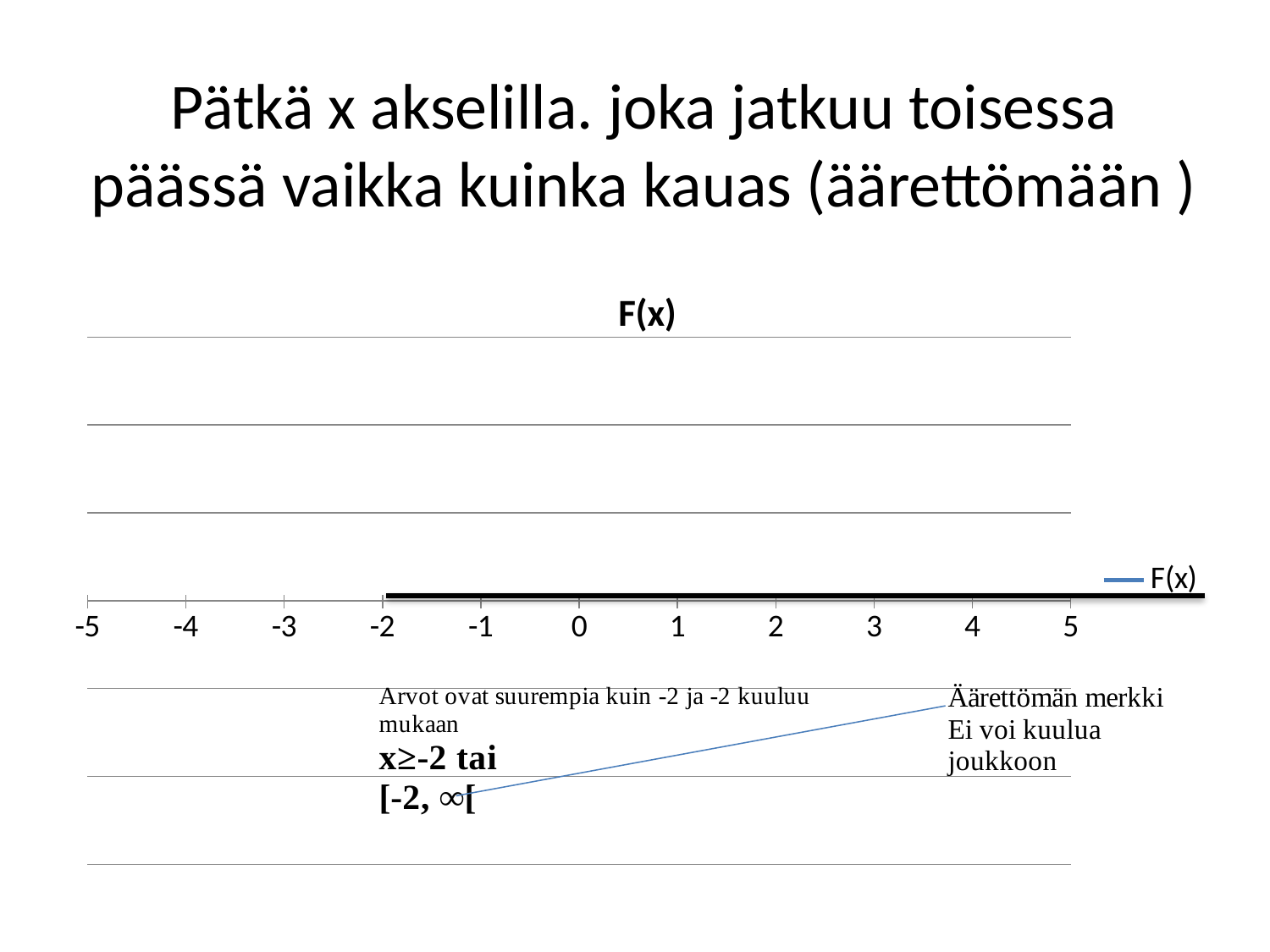
Does the plotted line extend to the left of x = -2? No How many series does the chart legend list? 1 Which interval notation is written below the chart for the plotted set? [-2, ∞[ What kind of chart is shown on the slide? line chart Does the plotted line rise, fall, or stay flat as x increases? stay flat At which x value does the plotted line begin? -2 What is the lowest value labelled on the x axis? -5 What is the title of the chart? F(x) What is the highest value labelled on the x axis? 5 How many tick labels are shown on the x axis? 11 What is the name of the series shown in the legend? F(x)